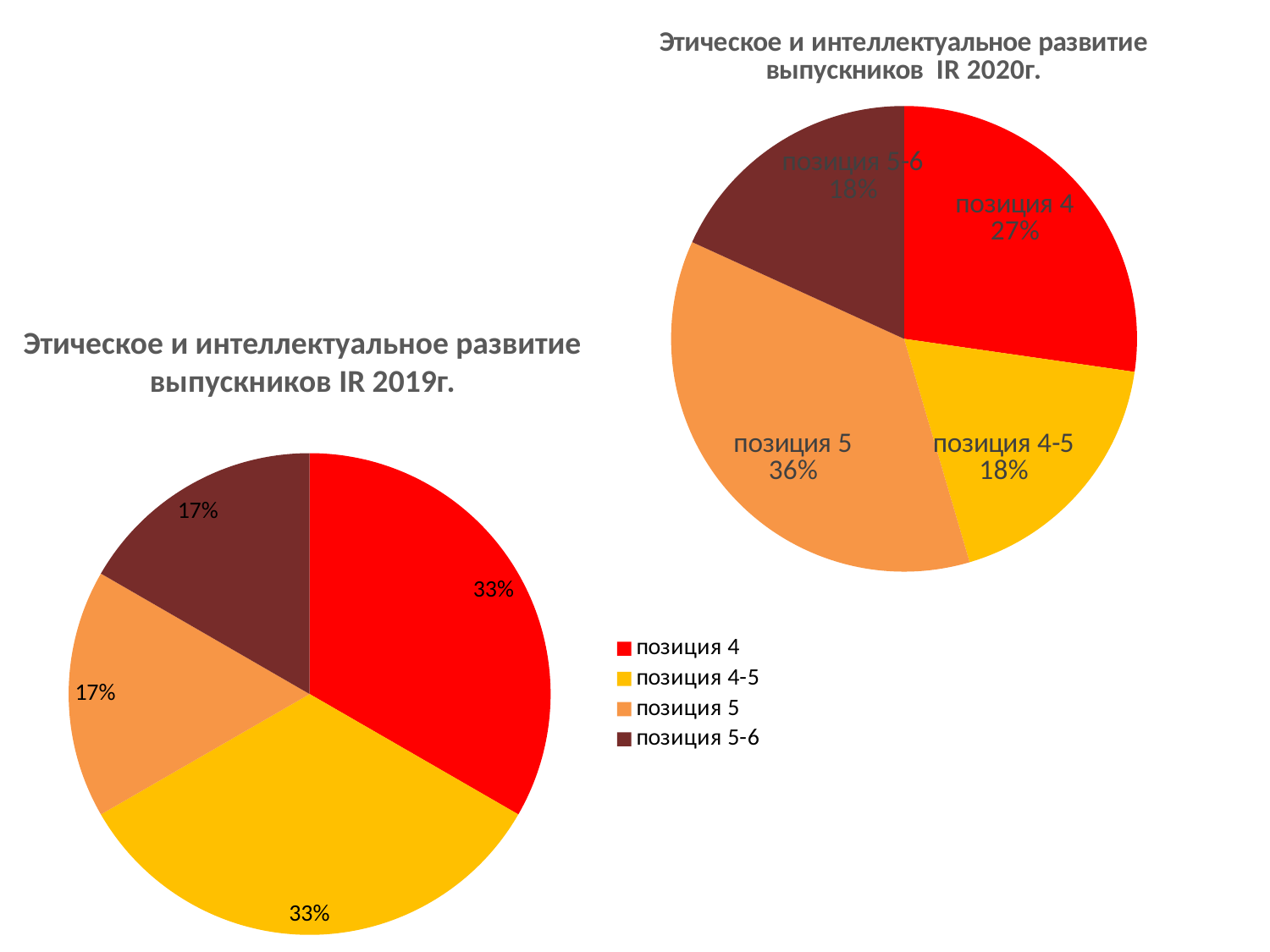
In the 2020 chart, what share does 'позиция 4-5' have? 18% What kind of chart is the 'Этическое и интеллектуальное развитие выпускников IR 2020г.' chart? pie chart In the 2020 chart, what share does 'позиция 4' have? 27% In the 2020 chart, which category has the largest share? позиция 5 In the 2019 chart, what share does the red slice ('позиция 4') have? 33% How many entries does the legend list? 4 In the 2020 chart, which is larger: 'позиция 4' or 'позиция 4-5'? позиция 4 In the 2019 chart, what is the difference between the shares of 'позиция 4-5' and 'позиция 5'? 16% In the 2020 chart, what is the difference between the shares of 'позиция 5' and 'позиция 4'? 9% In the 2019 chart, what share does the dark brown slice ('позиция 5-6') have? 17% How many slices does the 2019 chart have? 4 In the 2020 chart, what share does 'позиция 5' have? 36%